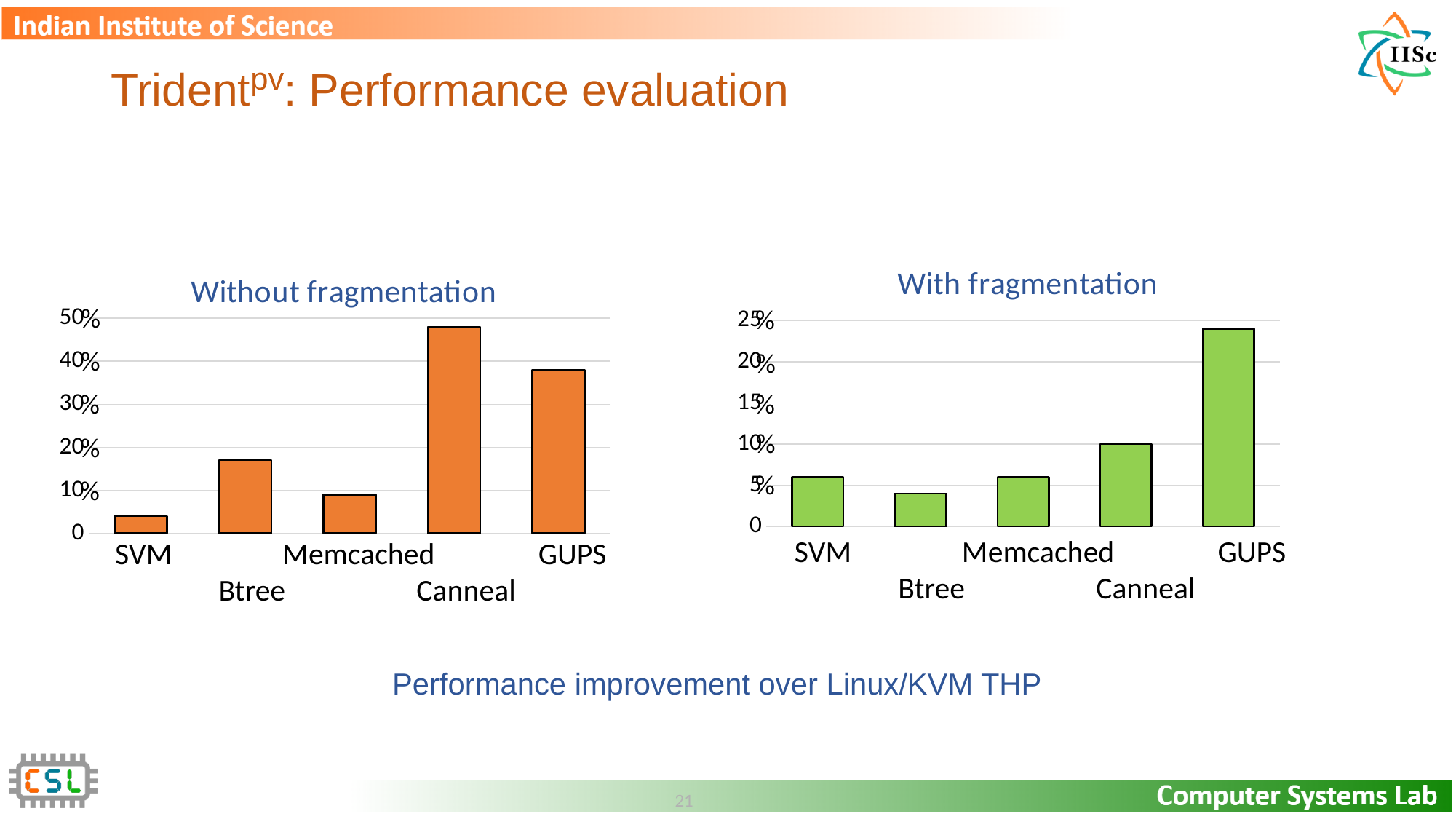
What type of chart is the 'With fragmentation' chart? Bar chart In the 'With fragmentation' chart, which category has the highest value? GUPS In the 'With fragmentation' chart, is the value for Btree greater or less than 5%? less In the 'Without fragmentation' chart, which is larger, the value for Btree or the value for Memcached? Btree In the 'With fragmentation' chart, which is larger, the value for Canneal or the value for GUPS? GUPS How many categories are shown in the 'Without fragmentation' chart? 5 In the 'Without fragmentation' chart, is the value for Canneal greater or less than 40%? greater In the 'With fragmentation' chart, which category has the lowest value? Btree In the 'With fragmentation' chart, is the value for GUPS greater or less than 20%? greater In the 'Without fragmentation' chart, which category has the lowest value? SVM In the 'Without fragmentation' chart, which category has the highest value? Canneal